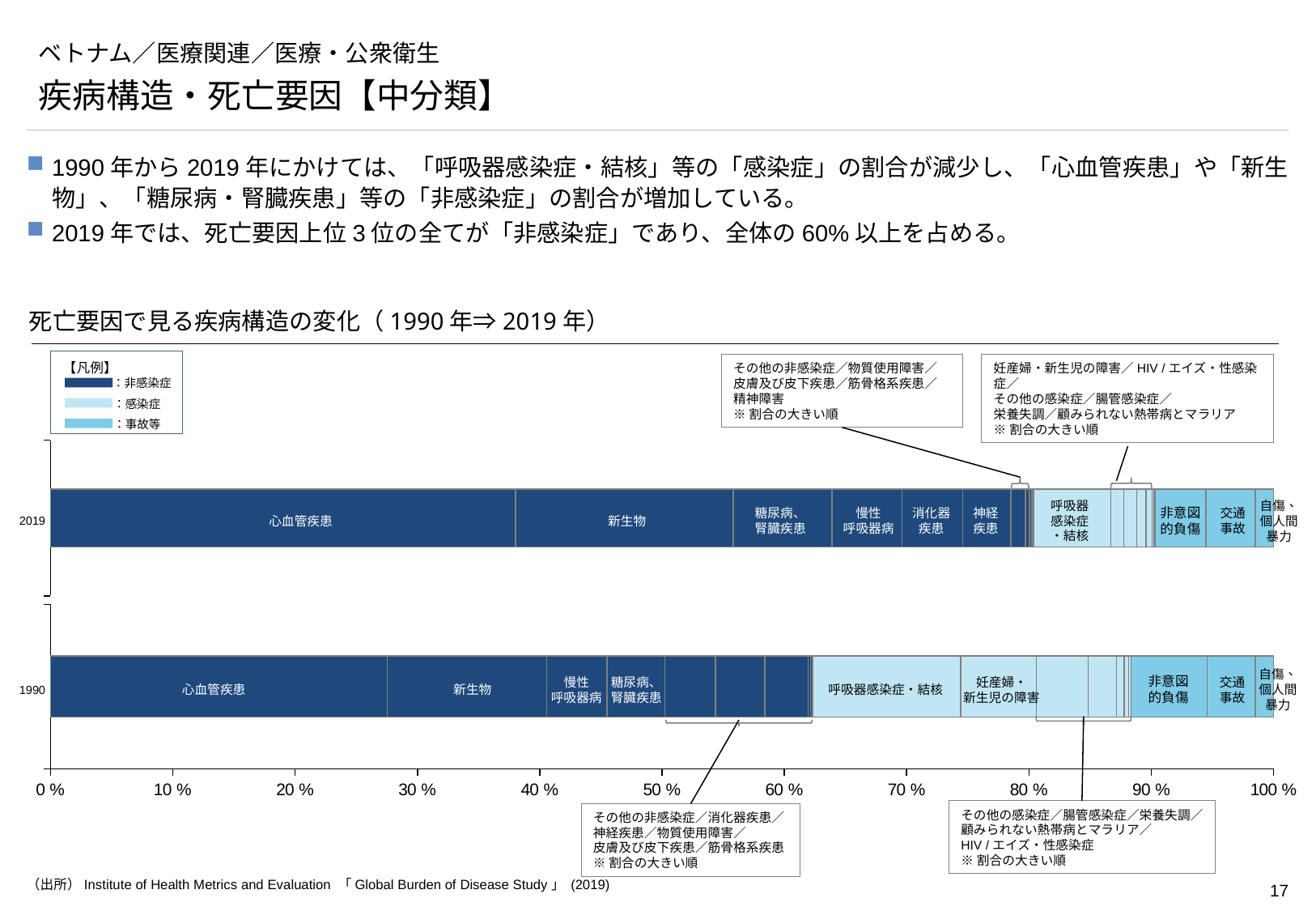
Is the share of 呼吸器感染症・結核 in 2019 greater or less than 10%? less Is the share of 心血管疾患 in 2019 greater or less than 30%? greater Is the share of 心血管疾患 in 1990 greater or less than 30%? less What kind of chart is shown on the slide? Stacked bar chart In which year is the share of 呼吸器感染症・結核 larger, 1990 or 2019? 1990 How many categories does the legend (凡例) list? 3 Which cause of death has the largest share in the 1990 bar? 心血管疾患 Which cause of death has the largest share in the 2019 bar? 心血管疾患 In which year is the share of 心血管疾患 larger, 1990 or 2019? 2019 How many bars (years) does the chart show? 2 What is the title of the chart? 死亡要因で見る疾病構造の変化（1990年⇒2019年）